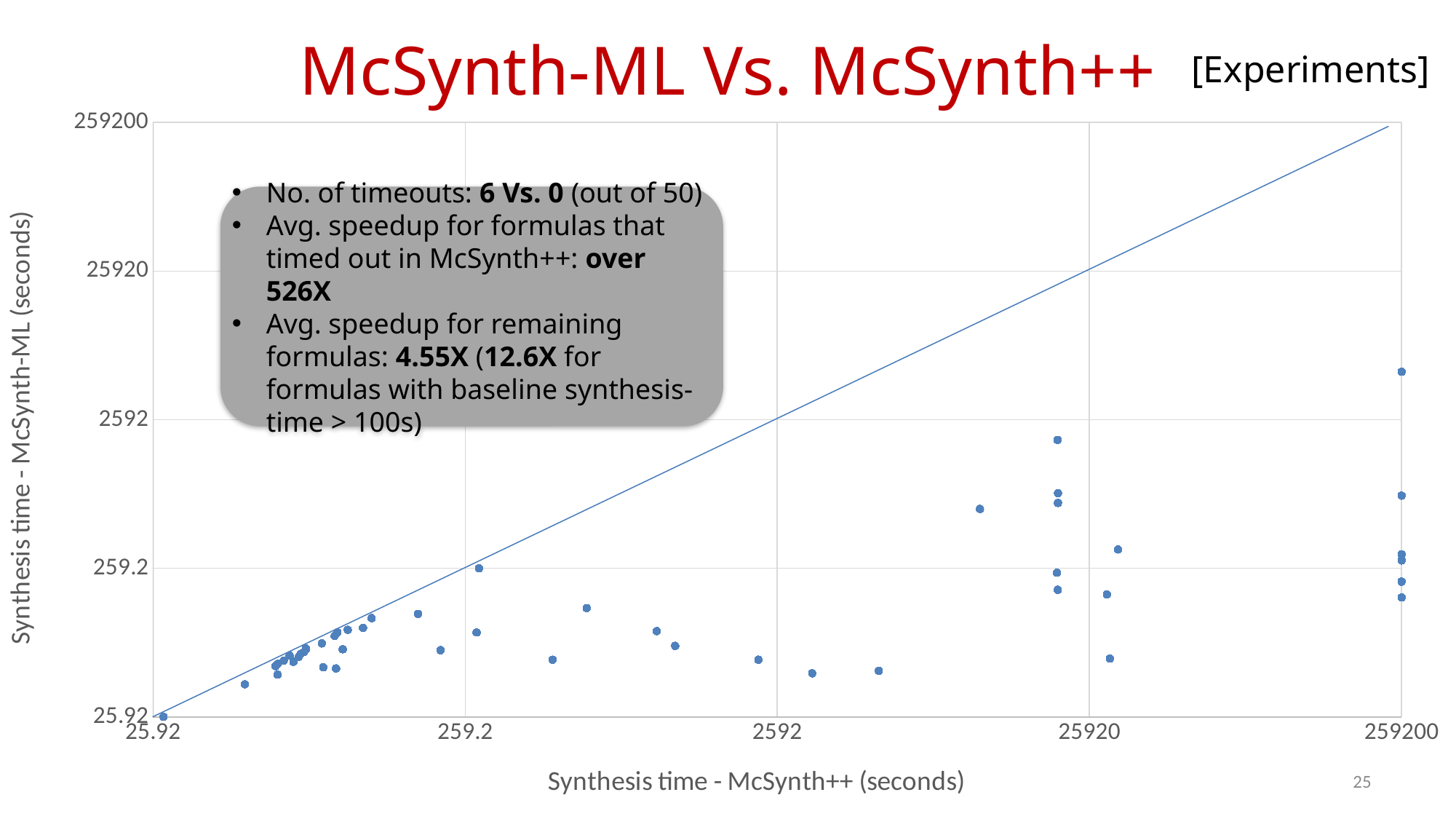
What is the highest tick value shown on the y axis? 259200 Is the McSynth-ML synthesis time for the highest point at McSynth++ time 259200 greater or less than 2592 seconds? greater What is the lowest tick value shown on the x axis? 25.92 What is the label of the y axis? Synthesis time - McSynth-ML (seconds) What kind of chart is shown on the slide? Scatter chart Is the McSynth-ML synthesis time for the point at McSynth++ time 2592 greater or less than 259.2 seconds? less What is the title of the chart? McSynth-ML Vs. McSynth++ What is the label of the x axis? Synthesis time - McSynth++ (seconds) How many tick labels are shown on the x axis? 5 Is the McSynth-ML synthesis time for the lowest point at McSynth++ time 259200 greater or less than 259.2 seconds? less Are most of the plotted points above or below the diagonal line? below